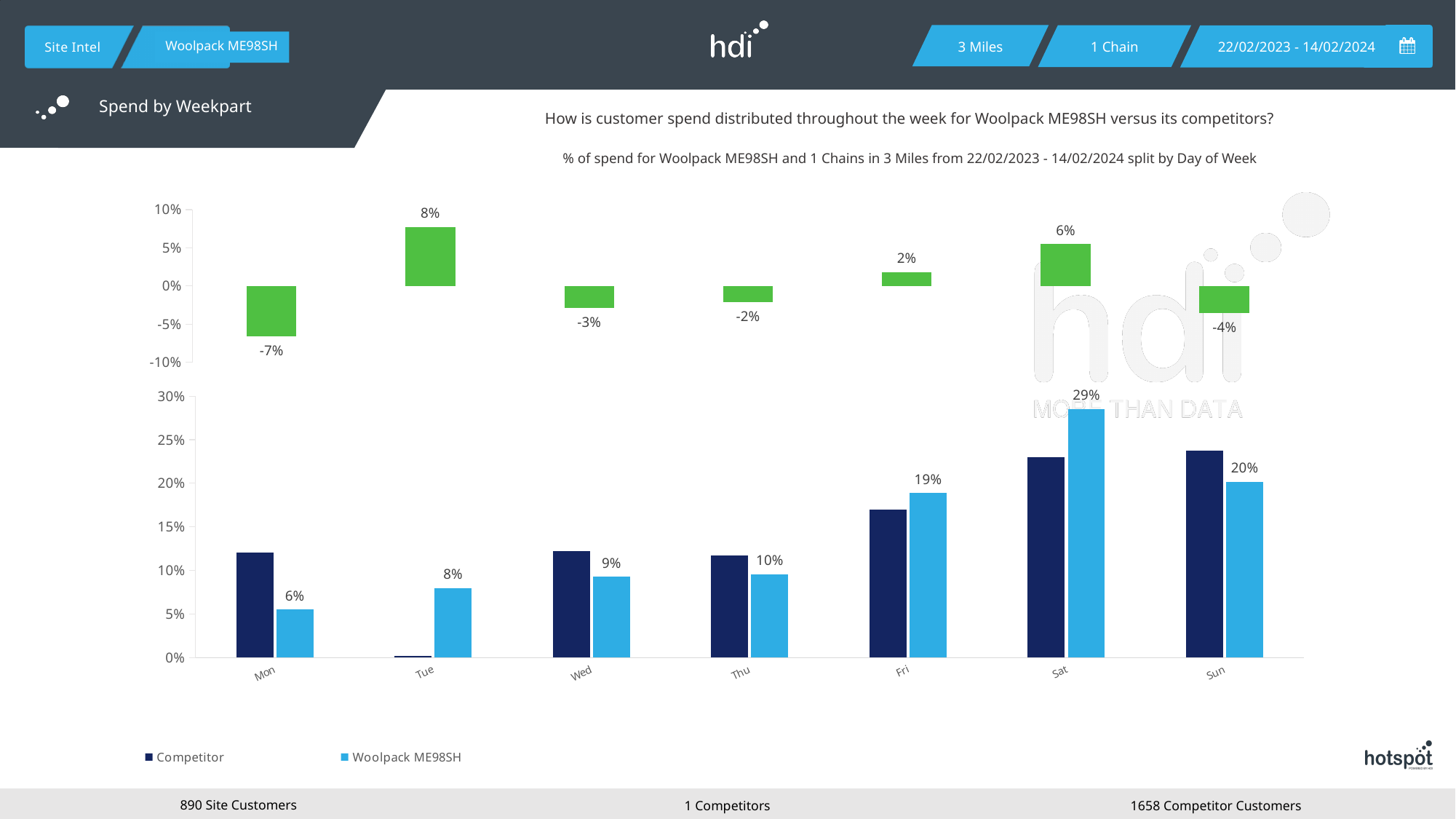
In the bottom chart, is the Competitor value for Tue greater or less than 5%? less In the bottom chart, on which day is the Woolpack ME98SH value highest? Sat In the bottom chart, on which day is the Woolpack ME98SH value lowest? Mon In the bottom chart, is the Competitor value for Mon greater or less than 10%? greater In the top chart, which day has the lowest value? Mon In the bottom chart, what is the difference between the Woolpack ME98SH values for Sat and Sun? 9% How many days of the week are shown on the x axis of the bottom chart? 7 In the top chart, which day has the highest value? Tue How many series does the legend of the bottom chart list? 2 In the bottom chart, what is the Woolpack ME98SH value for Sat? 29% In the top chart, what is the value shown for Tue? 8% In the bottom chart, which series has the larger value on Sat, Competitor or Woolpack ME98SH? Woolpack ME98SH